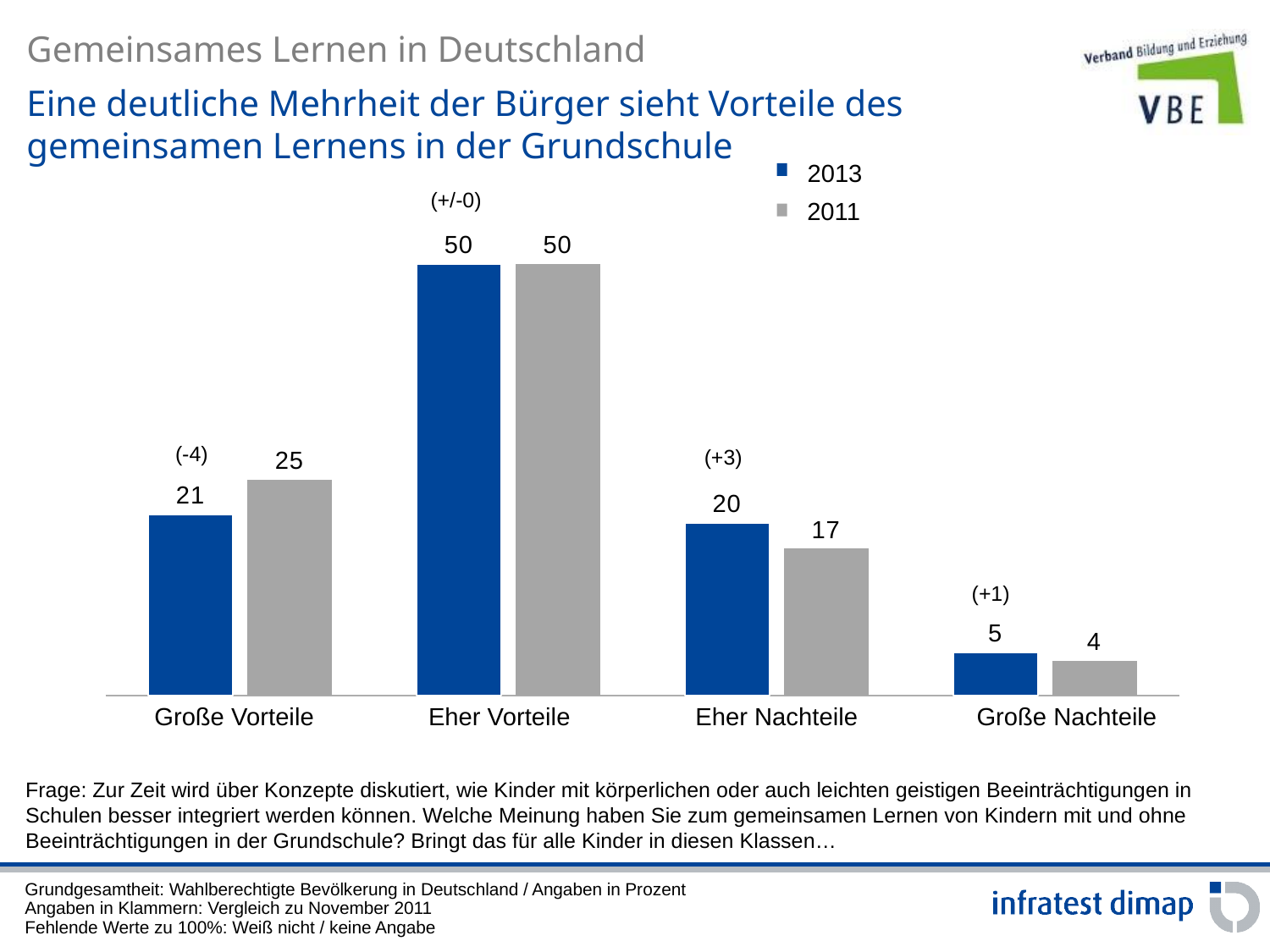
Which category has the lowest 2011 value? Große Nachteile How many series does the legend list? 2 What is the total of the 2013 values for Große Vorteile and Eher Vorteile? 71 What is the 2013 value for Große Nachteile? 5 Which is larger for Eher Nachteile, the 2013 value or the 2011 value? 2013 How many categories are shown on the x axis? 4 Which category has the highest 2013 value? Eher Vorteile What is the 2011 value for Eher Nachteile? 17 What is the 2013 value for Große Vorteile? 21 Which series is shown in blue? 2013 What is the difference between the 2011 and 2013 values for Große Vorteile? 4 What kind of chart is shown on the slide? Bar chart